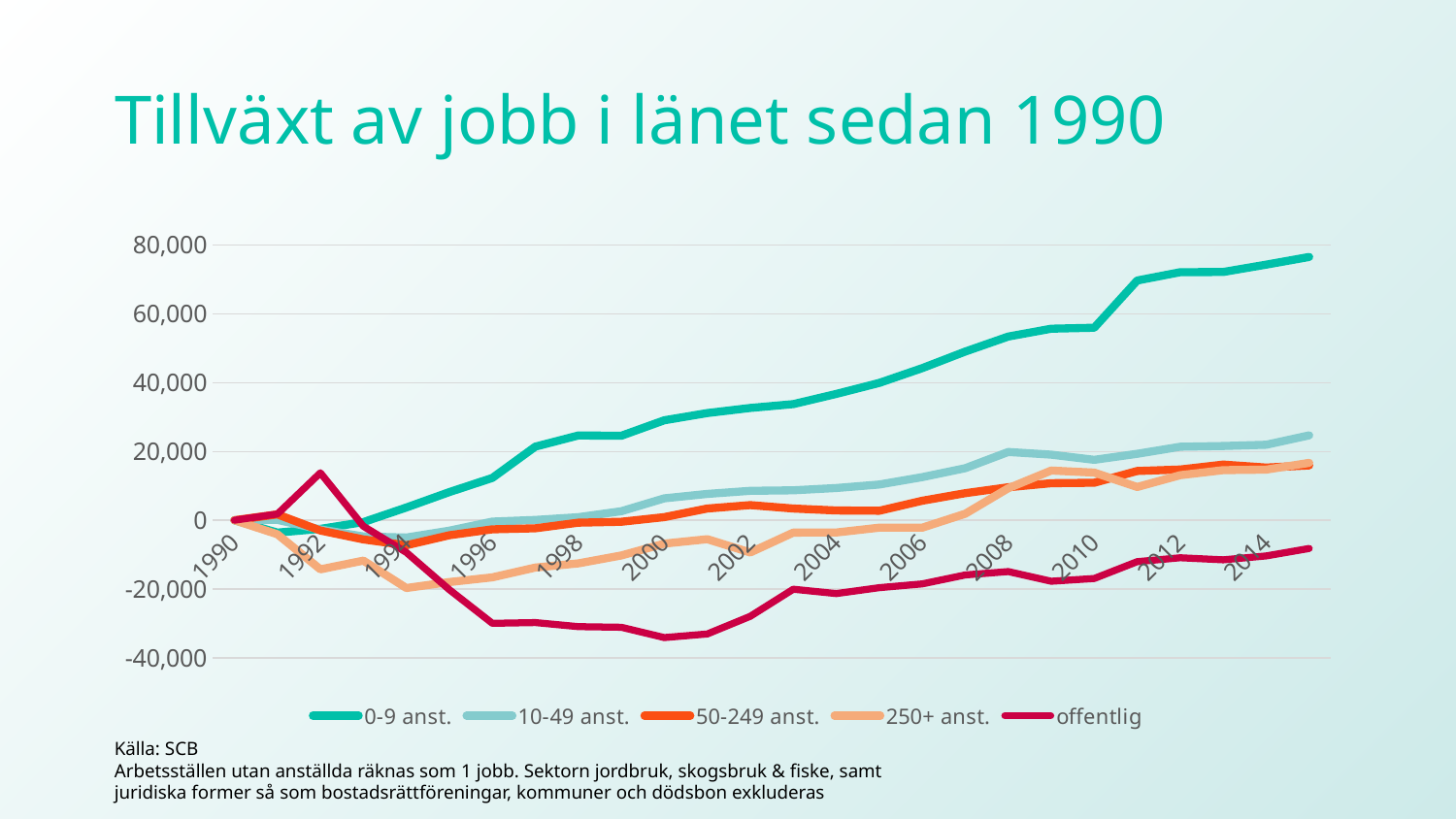
Which is larger in 2010, the value for 0-9 anst. or the value for offentlig? 0-9 anst. Is the value for 0-9 anst. in 2014 greater or less than 60,000? greater Is the value for 10-49 anst. in 2008 greater or less than 0? greater How many year labels are shown on the x axis? 13 Is the value for offentlig in 2000 greater or less than -20,000? less What source is cited below the chart? SCB What is the title of the chart? Tillväxt av jobb i länet sedan 1990 Does the 0-9 anst. series generally rise or fall from 1990 to 2014? rise How many series does the legend list? 5 Which series has the highest value in 2014? 0-9 anst. Which series has the lowest value in 2014? offentlig What kind of chart is shown on the slide? line chart